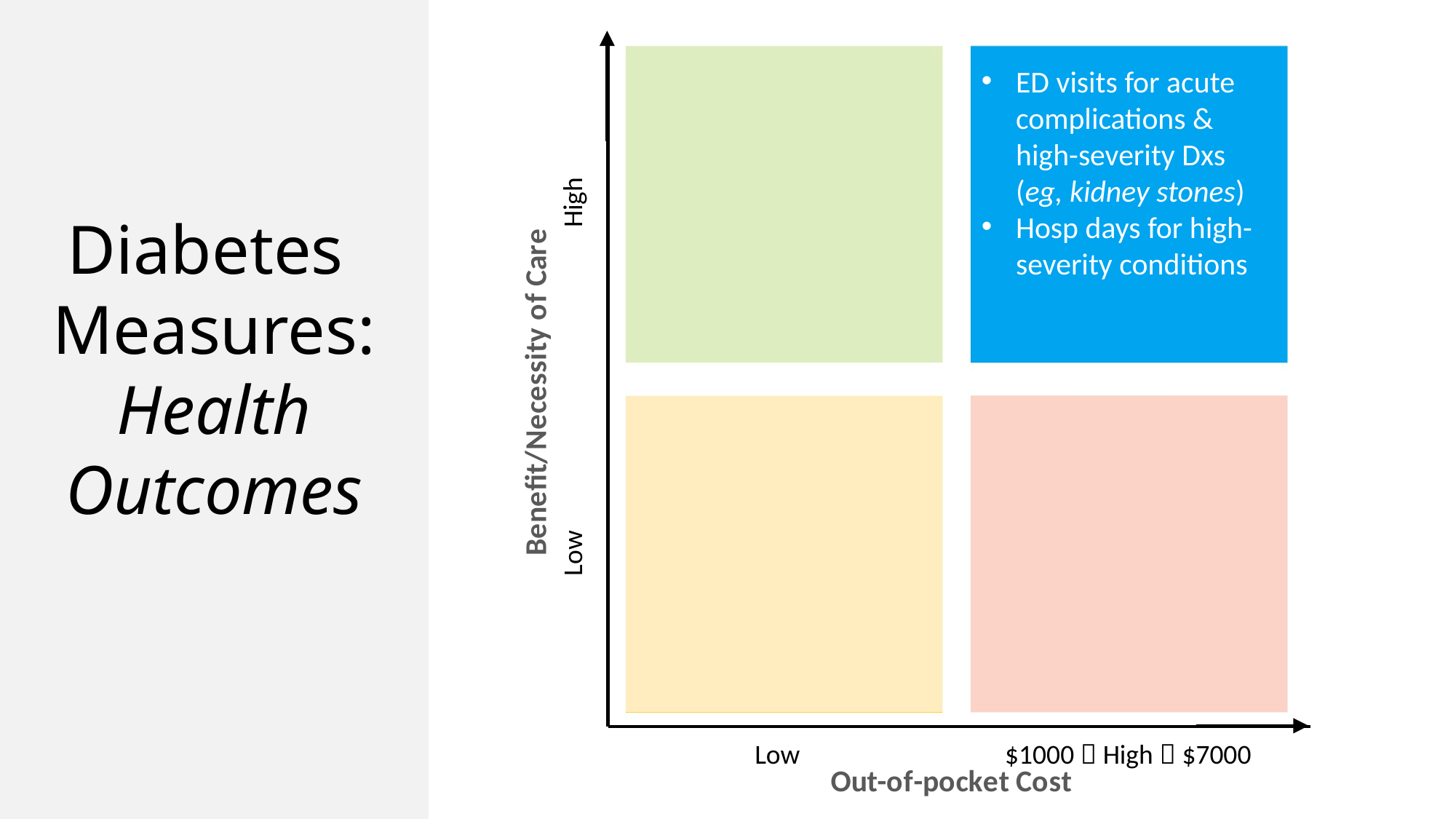
What is the label of the horizontal axis of the quadrant chart? Out-of-pocket Cost What is the label of the vertical axis of the quadrant chart? Benefit/Necessity of Care Which quadrant (by benefit and cost level) contains the text about ED visits for acute complications? High benefit, High cost How many quadrants does the chart contain? 4